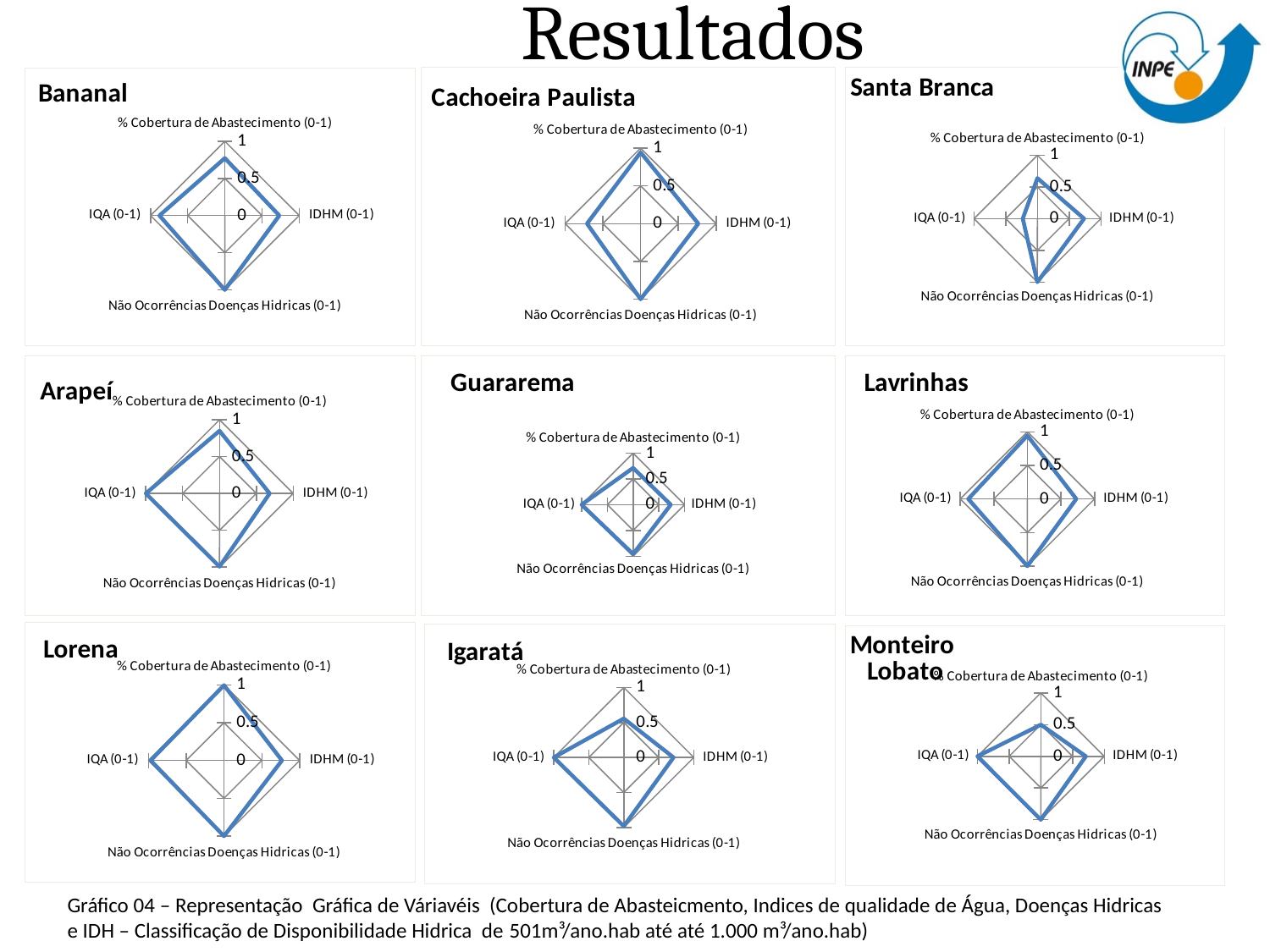
In the Monteiro Lobato chart, which variable has the highest value? IQA (0-1) and Não Ocorrências Doenças Hidricas (0-1) (both at 1) How many variables (axes) does the Bananal radar chart have? 4 How many radar charts are shown on the slide? 9 Which municipality's chart is in the top-right position of the grid? Santa Branca What kind of chart is used for each municipality on this slide? Radar chart In the Santa Branca chart, is the value for IQA (0-1) greater or less than 0.5? less In the Guararema chart, is the value for IQA (0-1) greater or less than 0.5? greater In the Bananal chart, is the value for IDHM (0-1) greater or less than 0.5? greater In the Santa Branca chart, which is larger, IDHM (0-1) or IQA (0-1)? IDHM (0-1) What is the maximum value shown on the radar axes of the Lorena chart? 1 In the Santa Branca chart, which variable has the lowest value? IQA (0-1)